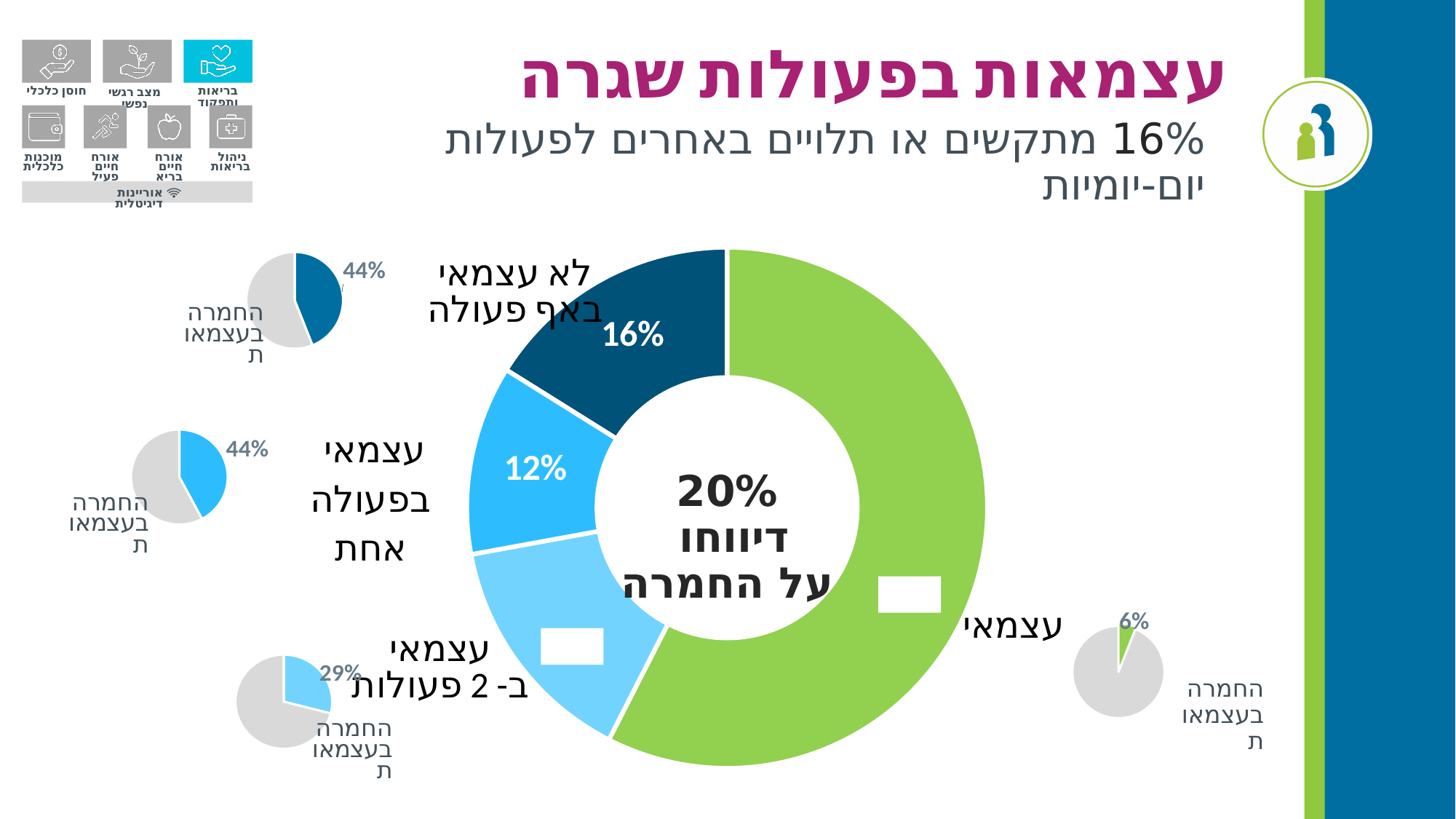
In the main donut chart, what is the value for the segment labeled לא עצמאי באף פעולה? 16% What percentage is printed in the centre of the main donut chart? 20% What kind of chart is the large chart in the centre of the slide? Donut (pie) chart How many segments does the main donut chart have? 4 In the small pie chart at the top left of the slide (next to לא עצמאי באף פעולה), what percentage is shown for החמרה בעצמאות? 44% In the main donut chart, which segment is the largest? עצמאי In the main donut chart, which is larger: לא עצמאי באף פעולה or עצמאי בפעולה אחת? לא עצמאי באף פעולה What is the title of the slide containing the donut chart? עצמאות בפעולות שגרה In the small pie chart at the bottom left of the slide (next to עצמאי ב-2 פעולות), what percentage is shown for החמרה בעצמאות? 29% In the small pie chart at the right of the slide (next to the עצמאי segment), what percentage is shown for החמרה בעצמאות? 6% In the main donut chart, what is the difference between the values for לא עצמאי באף פעולה and עצמאי בפעולה אחת? 4% In the main donut chart, what is the value for the segment labeled עצמאי בפעולה אחת? 12%